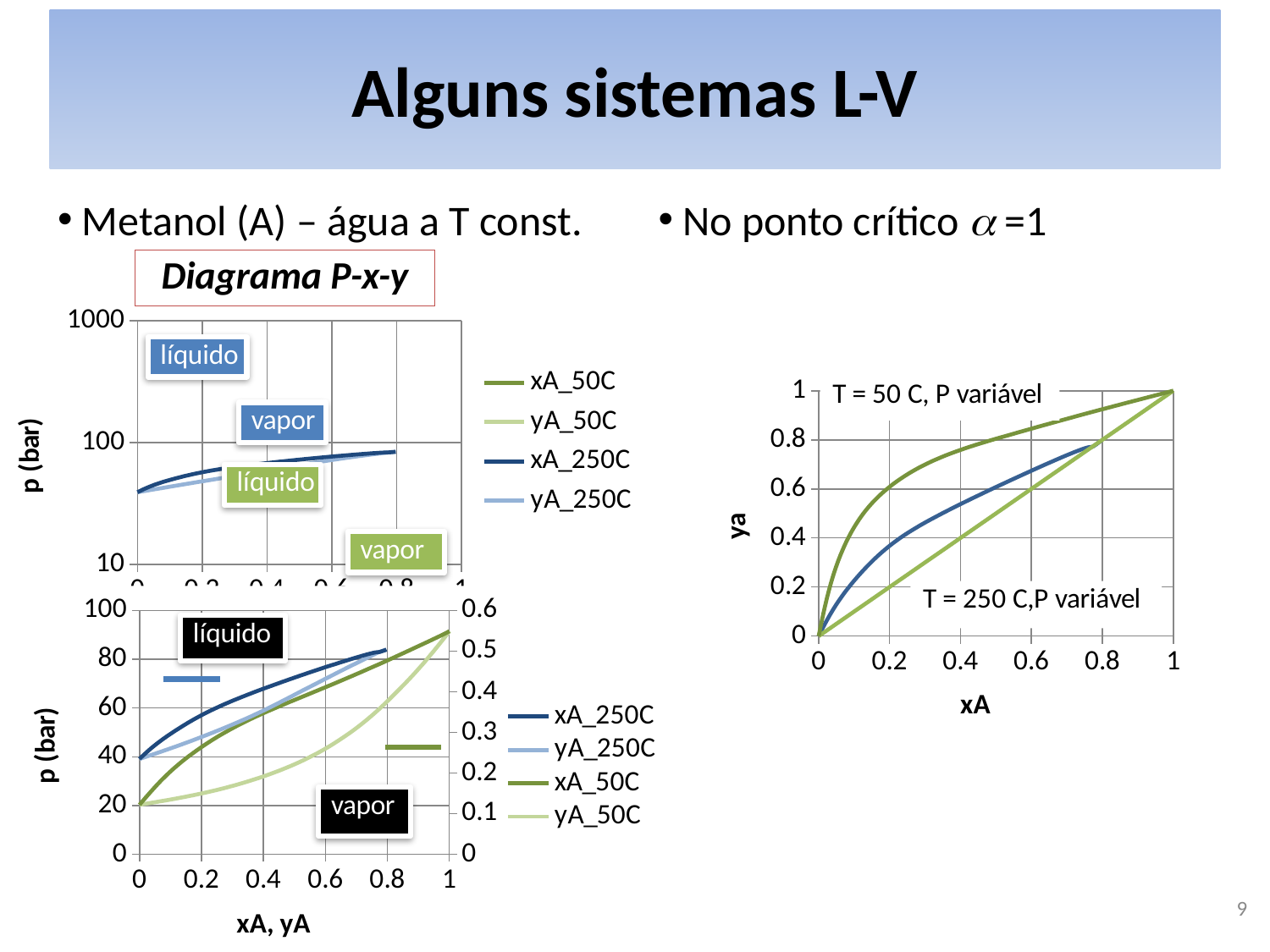
In the right-hand chart with axes 'xA' and 'ya', is the ya value of the 'T = 250 C,P variável' curve at xA = 0.4 greater or less than 0.4? greater In the bottom-left chart with the x axis labelled 'xA, yA', what is the highest tick value on the right-hand vertical axis? 0.6 In the right-hand chart with axes 'xA' and 'ya', at xA = 0.4, which curve has the higher ya value: 'T = 50 C, P variável' or 'T = 250 C,P variável'? T = 50 C, P variável In the bottom-left chart with the x axis labelled 'xA, yA', does the xA_250C series rise or fall as xA increases? rise What kind of chart is the bottom-left chart with the x axis labelled 'xA, yA'? line chart In the top-left chart titled 'Diagrama P-x-y', what is the highest tick value shown on the vertical axis? 1000 In the bottom-left chart with the x axis labelled 'xA, yA', is the value of the xA_250C series at xA = 0.4 greater or less than 60? greater In the bottom-left chart with the x axis labelled 'xA, yA', is the value of the xA_250C series at xA = 0.6 greater or less than 80? less In the right-hand chart with axes 'xA' and 'ya', does the 'T = 50 C, P variável' curve rise or fall as xA increases? rise In the bottom-left chart with the x axis labelled 'xA, yA', how many series does the legend list? 4 In the top-left chart titled 'Diagrama P-x-y', what is the label of the vertical axis? p (bar) In the top-left chart titled 'Diagrama P-x-y', how many series does the legend list? 4